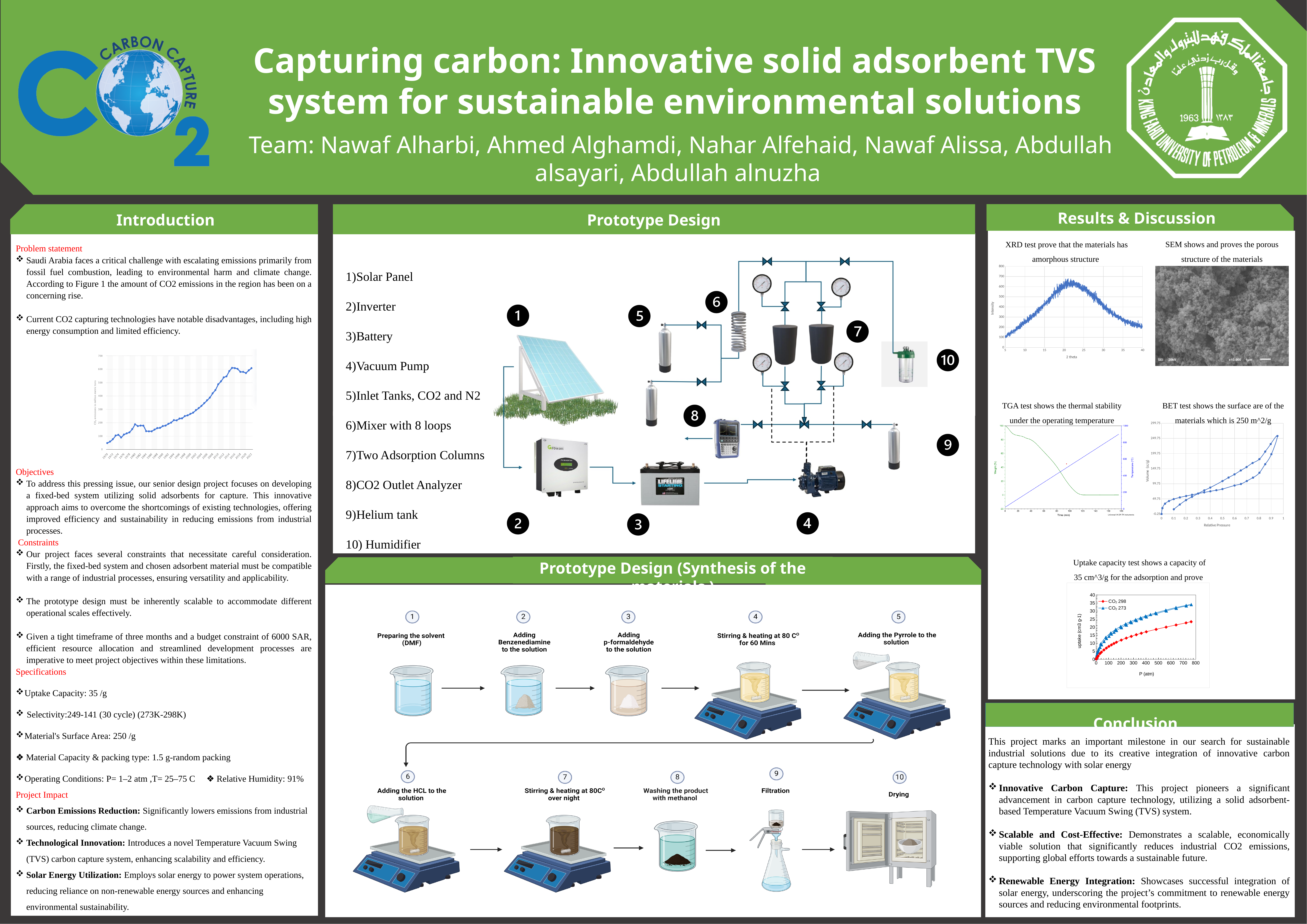
In the XRD test chart, is the peak intensity greater or less than 500? greater In the uptake capacity chart, do the uptake values rise or fall as P (atm) increases? rise In the uptake capacity chart, which series has the higher uptake values, CO₂ 298 or CO₂ 273? CO₂ 273 What is the x-axis label of the XRD test chart? 2 theta In the uptake capacity chart, is the highest value of the CO₂ 298 series greater or less than 30? less What kind of chart is the uptake capacity chart? line chart In the uptake capacity chart, what are the two series named in the legend? CO₂ 298 and CO₂ 273 In the uptake capacity chart, is the highest value of the CO₂ 273 series greater or less than 30? greater In the uptake capacity chart (bottom of Results & Discussion), how many series does the legend list? 2 In the TGA test chart, does the weight (%) line rise or fall as time increases? fall In the CO2 emissions line chart in the Introduction section, do the values rise or fall over the years? rise What kind of chart is the XRD test chart in the Results & Discussion section? line chart